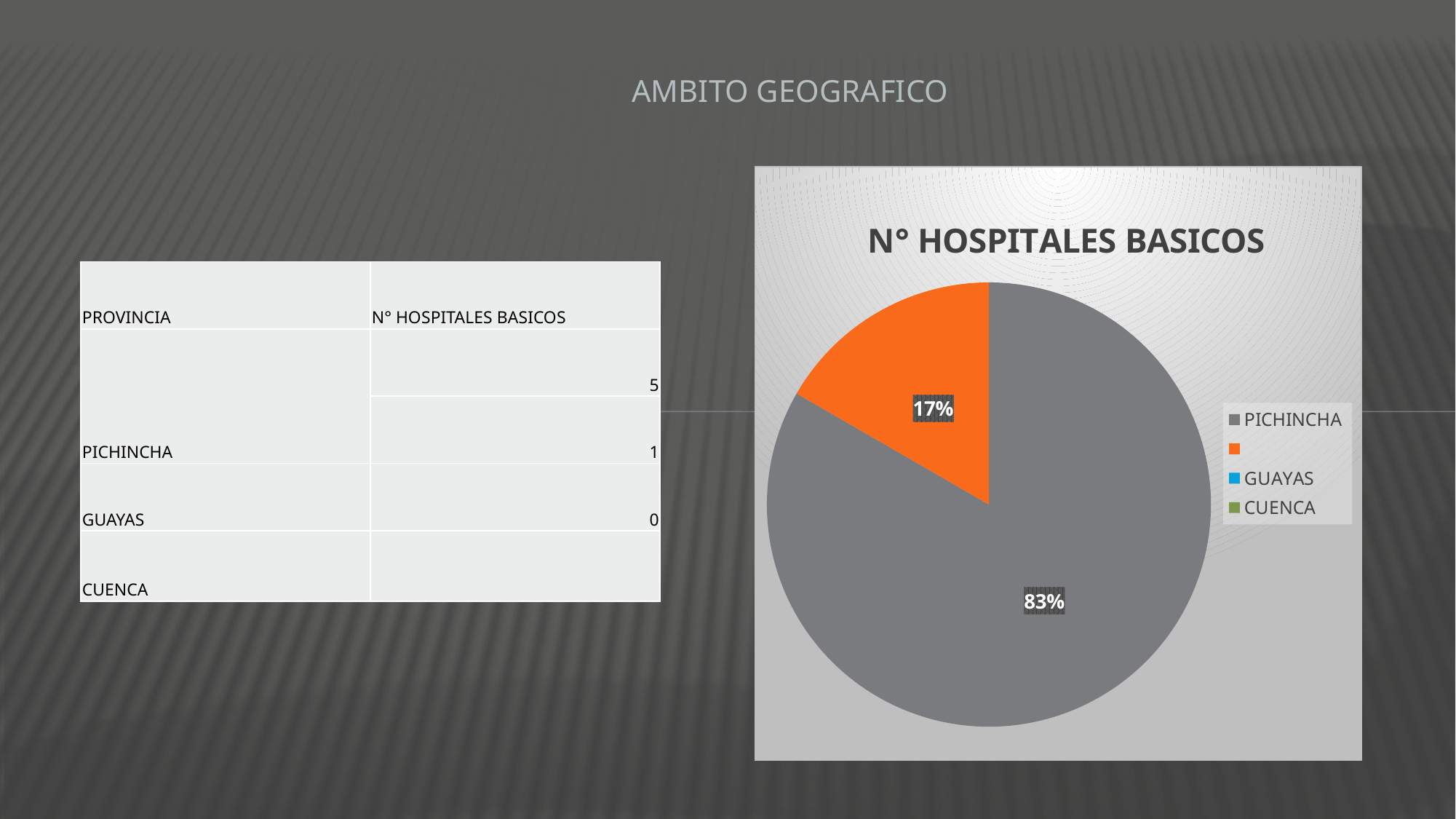
How many slices are visible in the pie? 2 What share of the pie does the orange slice have? 17% What colour is the PICHINCHA slice? gray Which category has the largest slice of the pie? PICHINCHA What share of the pie does PICHINCHA have? 83% What is the difference in percentage points between the PICHINCHA slice and the orange slice? 66 What kind of chart is shown on the slide? pie chart Which is larger, the PICHINCHA slice or the orange slice? PICHINCHA What is the title of the chart? N° HOSPITALES BASICOS How many entries does the legend list? 4